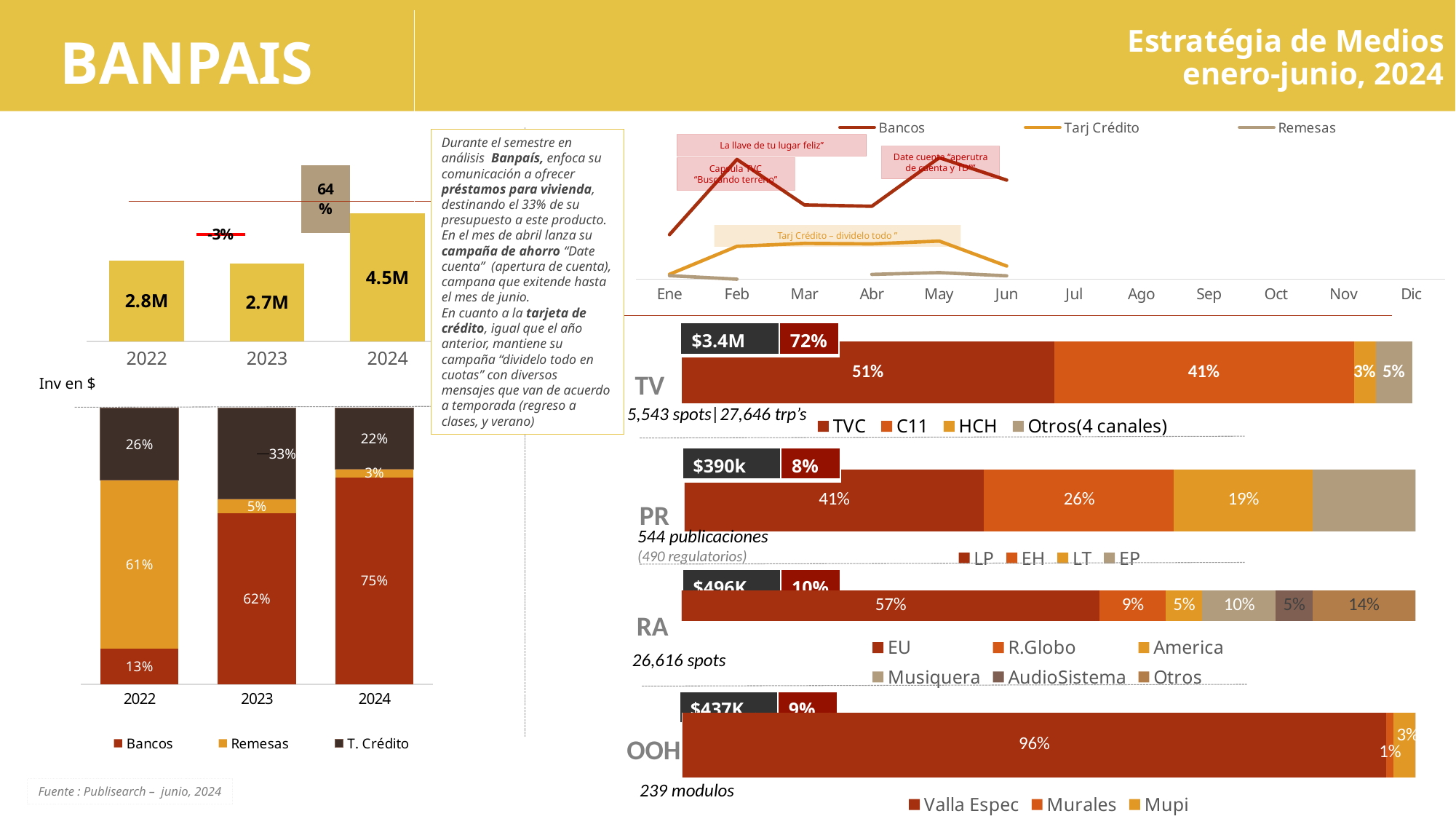
In the 'Inv en $' bar chart on the left, what is the difference between the 2024 and 2022 values? 1.7M In the TV bar on the right, which channel has the highest share? TVC In the 'Inv en $' bar chart on the left, what is the value for 2024? 4.5M In the OOH bar on the right, what is the share for Valla Espec? 96% In the TV bar on the right, what is the share for C11? 41% What kind of chart is the top-right chart showing Bancos, Tarj Crédito and Remesas by month? Line chart In the stacked bar chart at the bottom left, is the Bancos share larger in 2023 or in 2024? 2024 In the stacked bar chart at the bottom left, what is the Bancos share for 2024? 75% In the stacked bar chart at the bottom left, how many series does the legend list? 3 In the 'Inv en $' bar chart on the left, which year has the lowest investment? 2023 In the RA bar on the right, what is the share for Musiquera? 10% In the stacked bar chart at the bottom left, what is the Remesas share for 2022? 61%